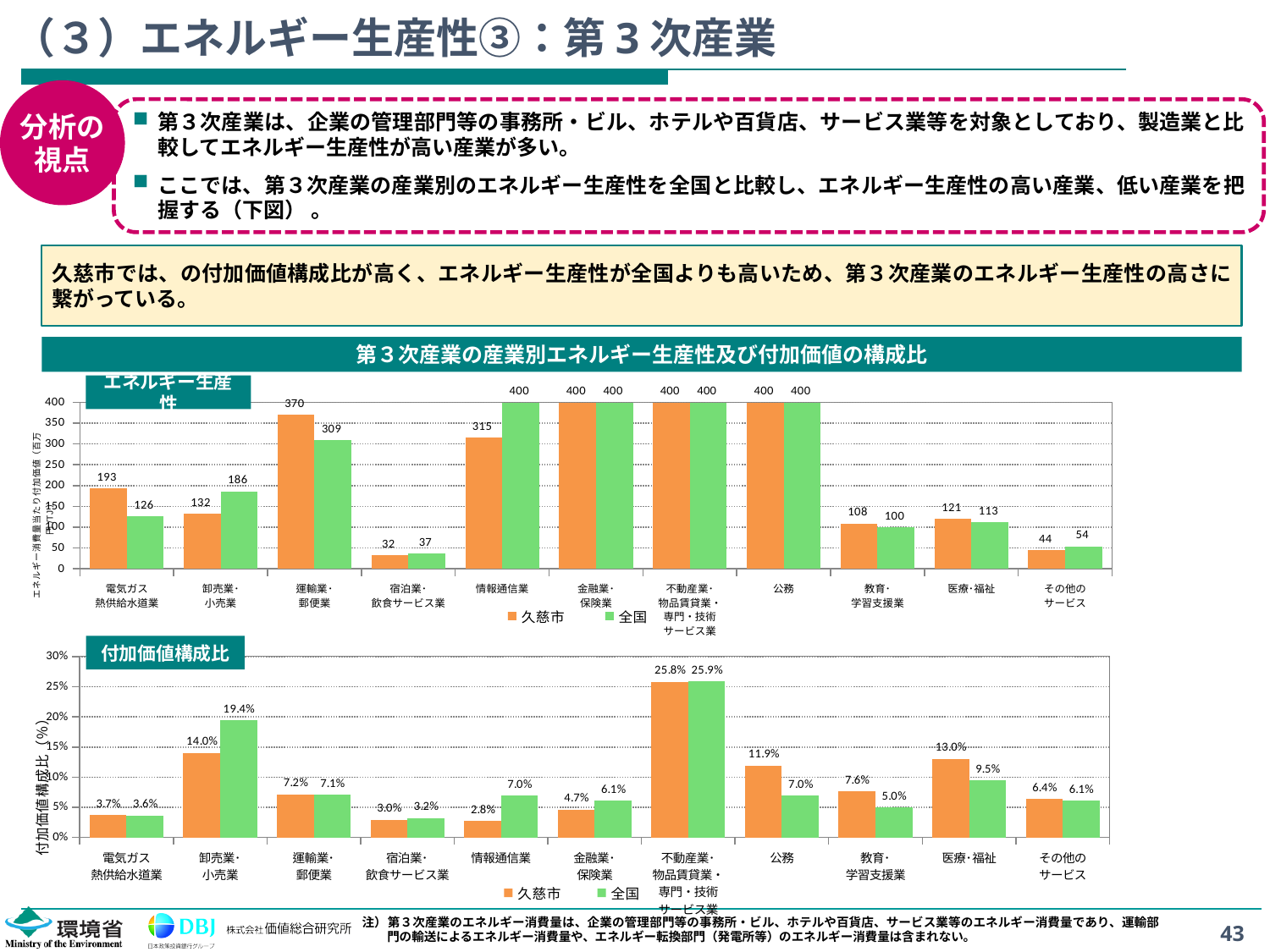
How many series does the legend of the bottom chart (付加価値構成比) list? 2 In the bottom chart (付加価値構成比), which is larger for 公務: 久慈市 or 全国? 久慈市 In the bottom chart (付加価値構成比), what is the value for 全国 in 卸売業・小売業? 19.4% In the top chart (エネルギー生産性), is the 久慈市 value for 情報通信業 greater or less than 300? greater In the top chart (エネルギー生産性), how many categories are shown on the x axis? 11 In the bottom chart (付加価値構成比), which category has the highest 久慈市 value? 不動産業・物品賃貸業・専門・技術サービス業 In the top chart (エネルギー生産性), which category has the lowest 久慈市 value? 宿泊業・飲食サービス業 What type of chart is the top chart (エネルギー生産性)? bar chart In the top chart (エネルギー生産性), what is the difference between 久慈市 and 全国 for 卸売業・小売業? 54 In the top chart (エネルギー生産性), what is the value for 全国 in 電気ガス熱供給水道業? 126 In the top chart (エネルギー生産性), what is the value for 久慈市 in 運輸業・郵便業? 370 In the bottom chart (付加価値構成比), what is the difference between 全国 and 久慈市 for 情報通信業? 4.2%